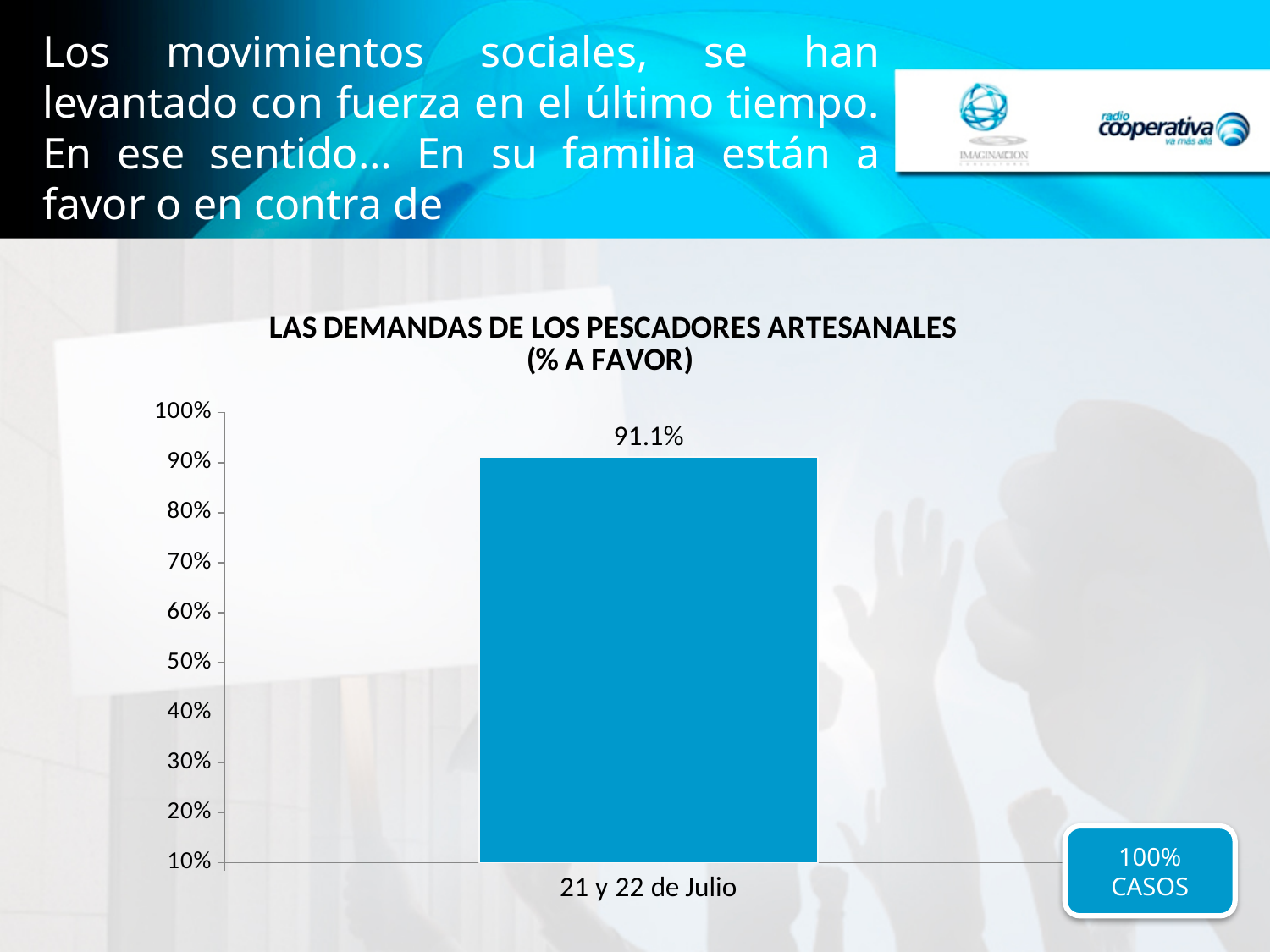
What is the lowest value shown on the y axis of the chart? 10% Is the value for "21 y 22 de Julio" greater or less than 100%? less Is the value for "21 y 22 de Julio" greater or less than 90%? greater What is the category label on the x axis of the chart? 21 y 22 de Julio What is the highest value shown on the y axis of the chart? 100% What kind of chart is shown on the slide? bar chart How many bars does the chart show? 1 What is the value shown for "21 y 22 de Julio"? 91.1% What is the title of the chart? LAS DEMANDAS DE LOS PESCADORES ARTESANALES (% A FAVOR)